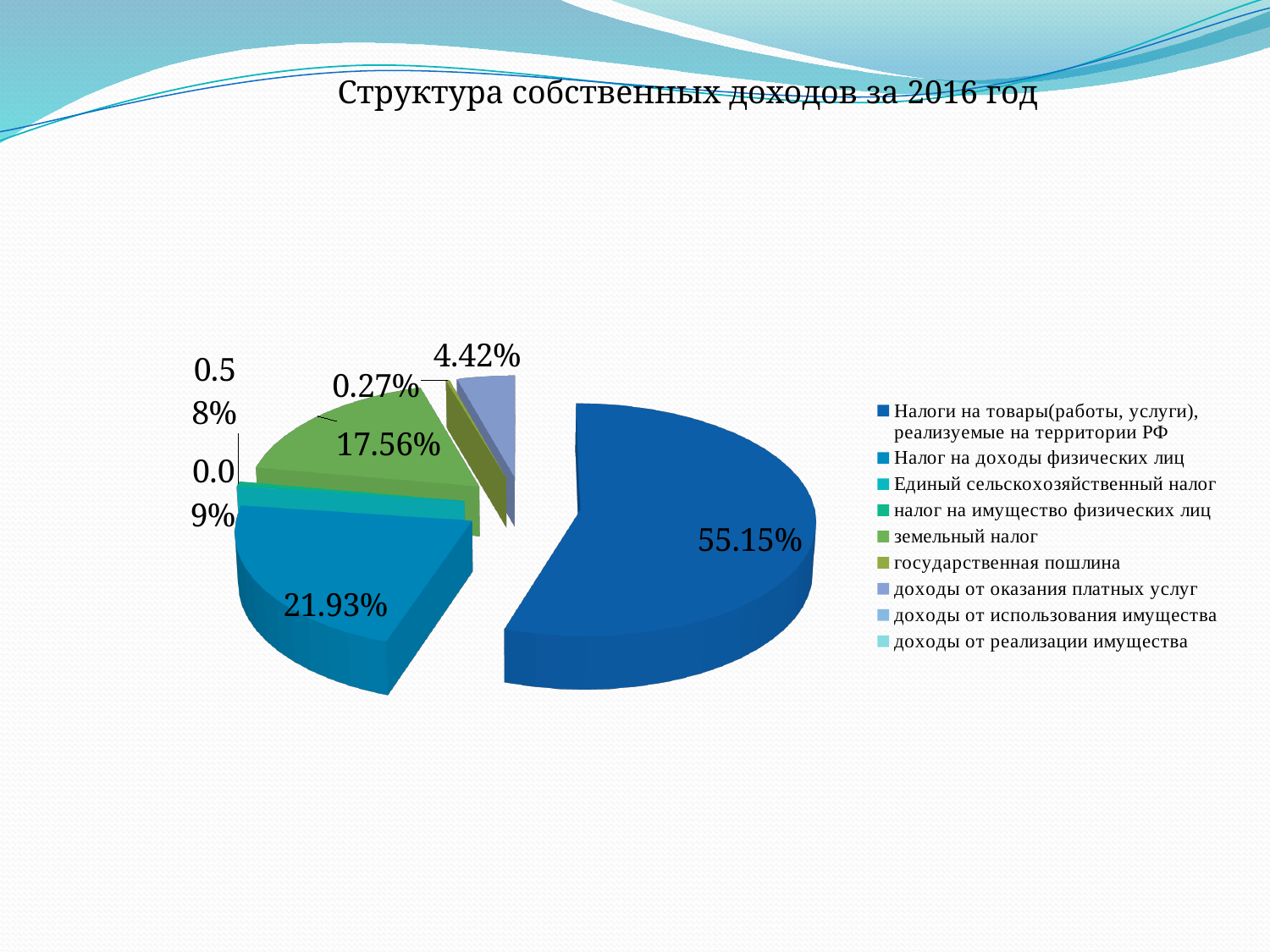
What is the title of the chart? Структура собственных доходов за 2016 год What share of the pie is labelled for Налог на доходы физических лиц? 21.93% What kind of chart is shown on the slide? pie chart What is the combined share of Налог на доходы физических лиц and земельный налог? 39.49% Which category has the largest share of the pie? Налоги на товары(работы, услуги), реализуемые на территории РФ What share of the pie is labelled for Налоги на товары(работы, услуги), реализуемые на территории РФ? 55.15% How many entries does the chart legend list? 9 Which is larger: the share for Налог на доходы физических лиц or the share for земельный налог? Налог на доходы физических лиц Does the largest slice account for more or less than half of the pie? more What colour is the slice representing Налоги на товары(работы, услуги), реализуемые на территории РФ? dark blue What share of the pie is labelled for земельный налог? 17.56% By how many percentage points does the share for Налоги на товары(работы, услуги), реализуемые на территории РФ exceed the share for Налог на доходы физических лиц? 33.22